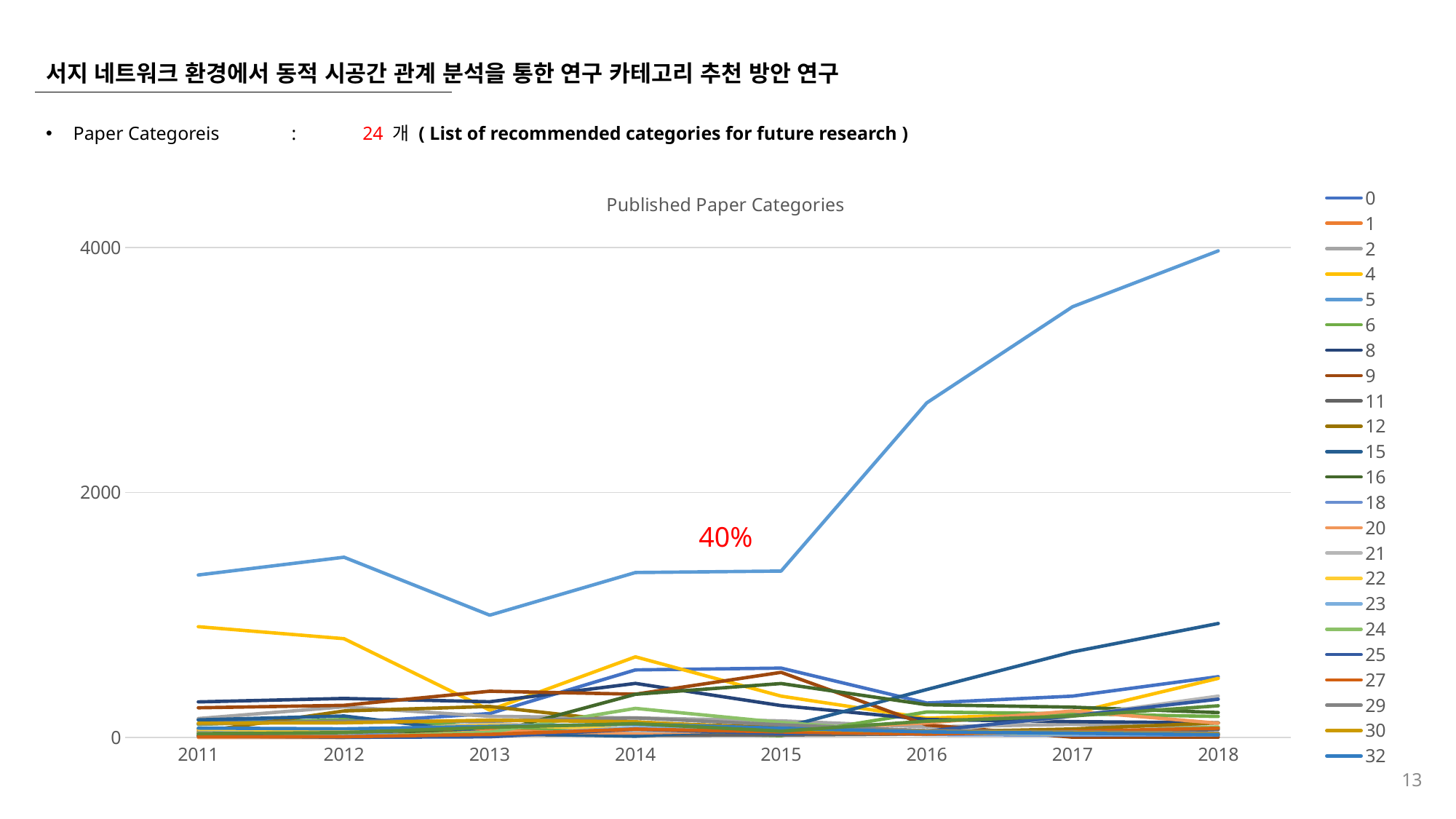
Is the value for series 5 in 2016 greater or less than 2000? greater Is the value for series 5 in 2018 greater or less than 2000? greater Does series 5 rise or fall between 2015 and 2018? rise In which year does series 5 reach its highest value? 2018 Which is larger for series 5: the value in 2011 or the value in 2018? 2018 What is the title of the chart? Published Paper Categories How many years are shown along the x axis of the chart? 8 In which year does series 5 reach its lowest value? 2013 What kind of chart is shown on the slide? line chart Which series reaches the highest value on the chart? 5 Is the value for series 5 in 2011 greater or less than 2000? less What percentage annotation is written in red on the chart? 40%